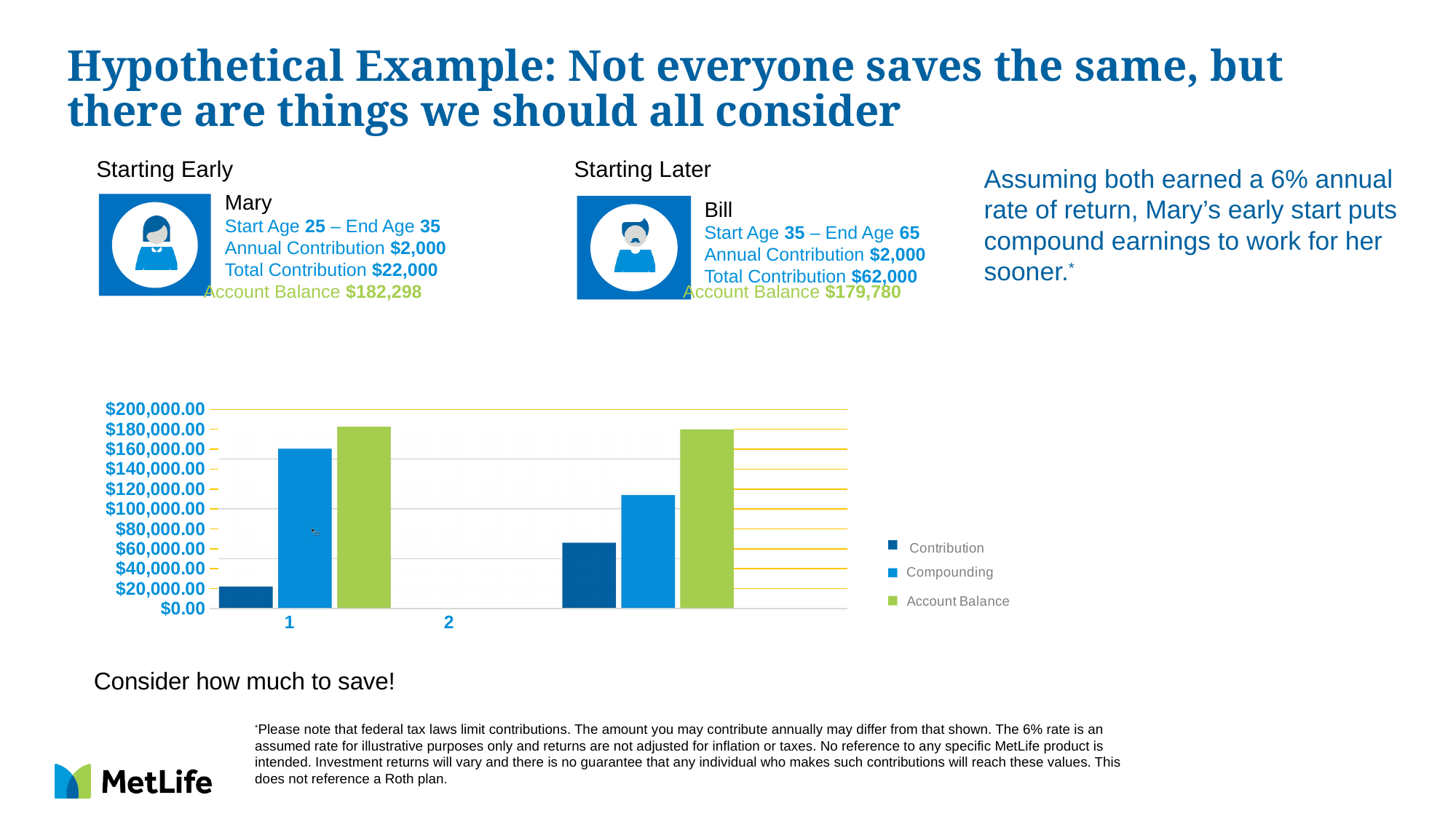
How many series does the chart legend list? 3 What kind of chart is shown on the slide? bar chart Which series has the highest value in category 1? Account Balance Which series has the lowest value in category 1? Contribution Is the Compounding value for category 1 greater or less than $140,000.00? greater How many categories are shown on the x axis of the chart? 2 Is the Contribution value for category 1 greater or less than $40,000.00? less